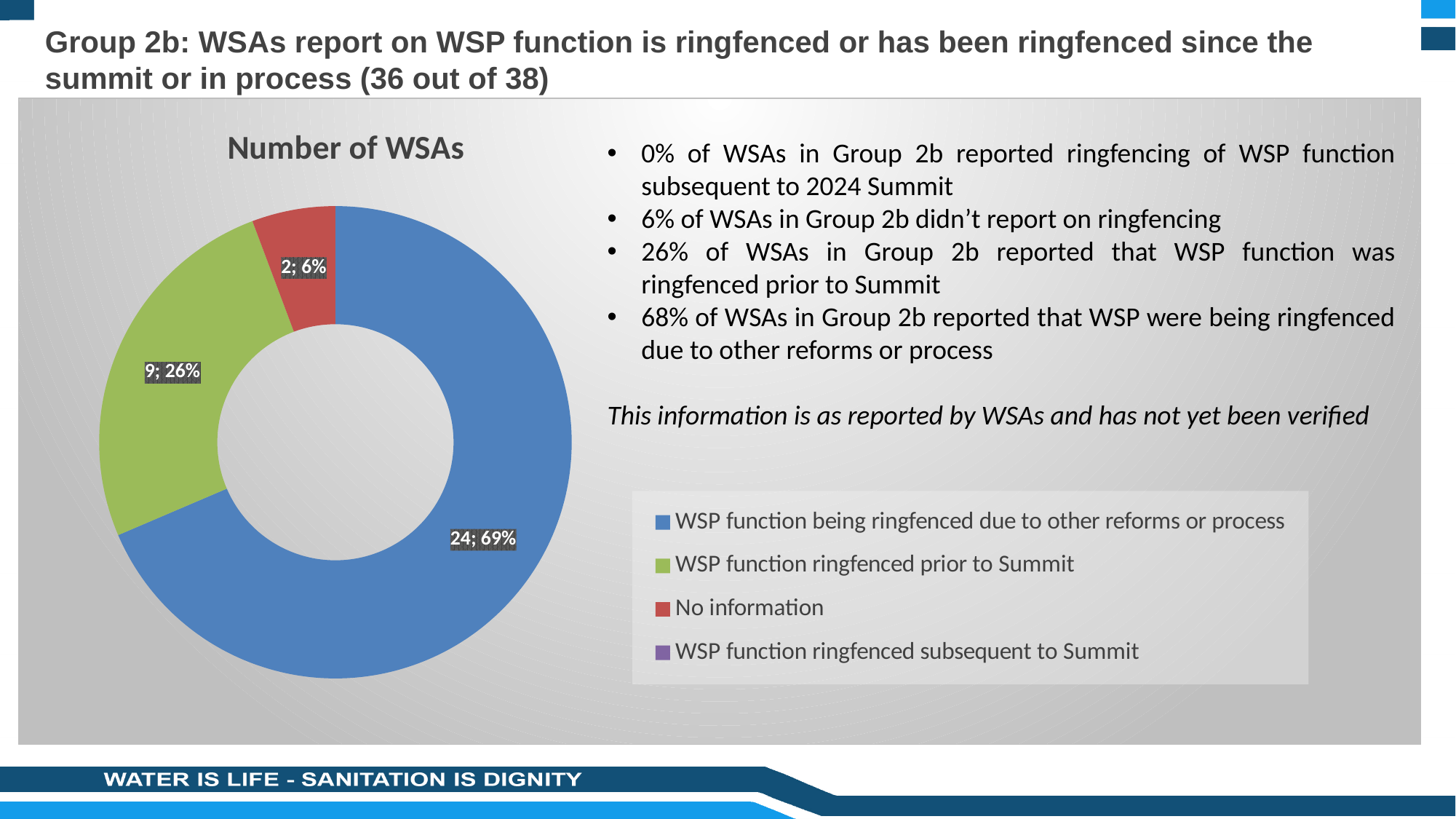
What share of the chart does the 'WSP function ringfenced prior to Summit' slice represent? 26% How many WSAs are in the 'WSP function being ringfenced due to other reforms or process' slice? 24 Which category with a visible slice has the smallest share in the chart? No information How many entries does the chart legend list? 4 Which category has the largest slice in the chart? WSP function being ringfenced due to other reforms or process What share of the chart does the 'WSP function being ringfenced due to other reforms or process' slice represent? 69% What is the title of the chart? Number of WSAs How many WSAs are in the 'WSP function ringfenced prior to Summit' slice? 9 How many WSAs are in the 'No information' slice? 2 What is the difference in the number of WSAs between the 'WSP function being ringfenced due to other reforms or process' slice and the 'WSP function ringfenced prior to Summit' slice? 15 What share of the chart does the 'No information' slice represent? 6% What type of chart is shown on the slide? Doughnut (pie) chart